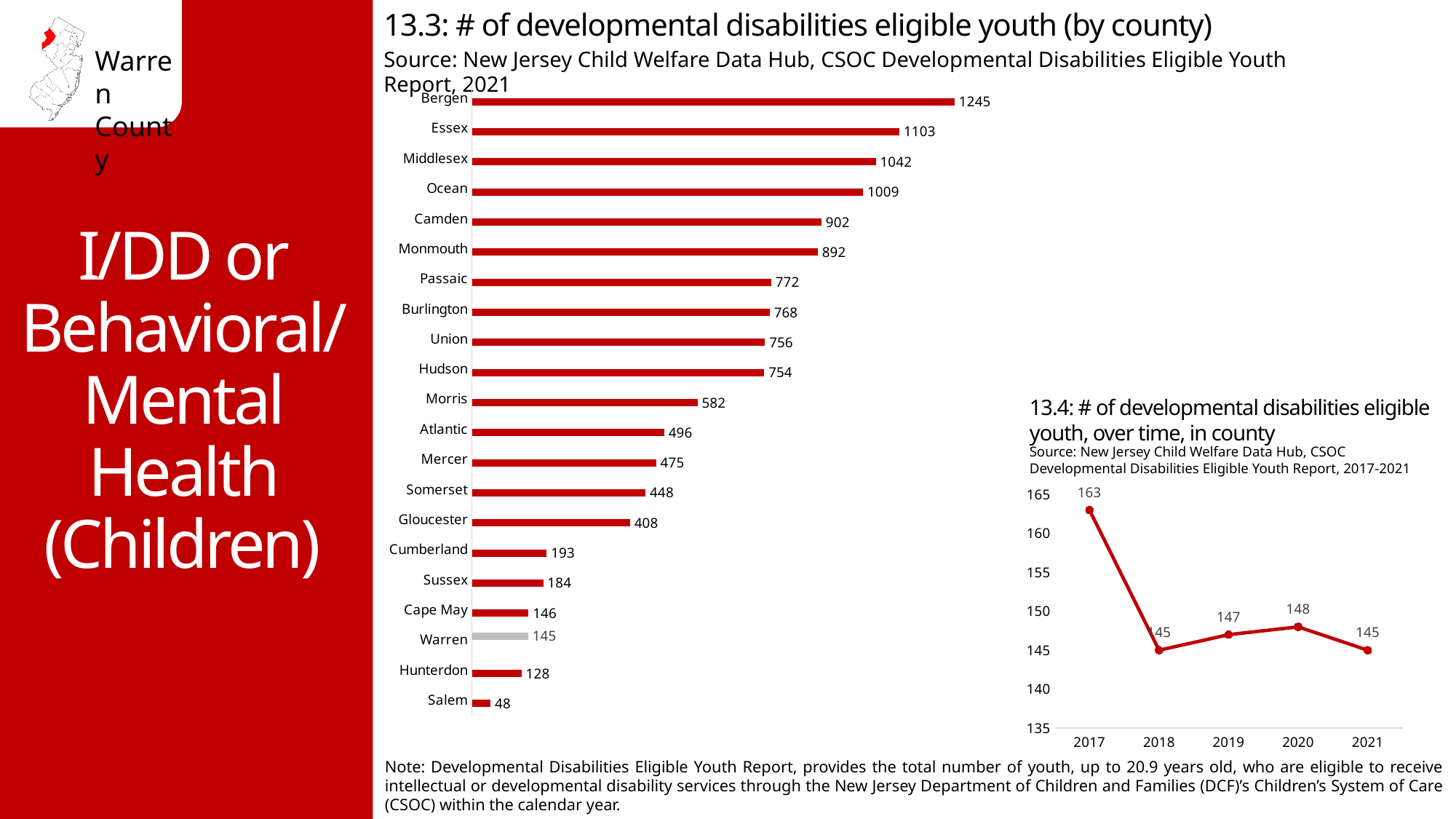
In the chart '13.4: # of developmental disabilities eligible youth, over time, in county', what is the difference between 2017 and 2021? 18 What kind of chart is '13.4: # of developmental disabilities eligible youth, over time, in county'? Line chart In the chart '13.4: # of developmental disabilities eligible youth, over time, in county', what is the value for 2017? 163 How many counties are shown in the chart '13.3: # of developmental disabilities eligible youth (by county)'? 21 What kind of chart is '13.3: # of developmental disabilities eligible youth (by county)'? Bar chart In the chart '13.4: # of developmental disabilities eligible youth, over time, in county', which year has the highest value? 2017 In the chart '13.3: # of developmental disabilities eligible youth (by county)', what is the difference between Essex and Middlesex? 61 In the chart '13.3: # of developmental disabilities eligible youth (by county)', which is larger, Cumberland or Sussex? Cumberland In the chart '13.3: # of developmental disabilities eligible youth (by county)', which county has the highest value? Bergen In the chart '13.3: # of developmental disabilities eligible youth (by county)', which county has the lowest value? Salem In the chart '13.3: # of developmental disabilities eligible youth (by county)', what is the value for Warren? 145 In the chart '13.3: # of developmental disabilities eligible youth (by county)', what is the value for Bergen? 1245